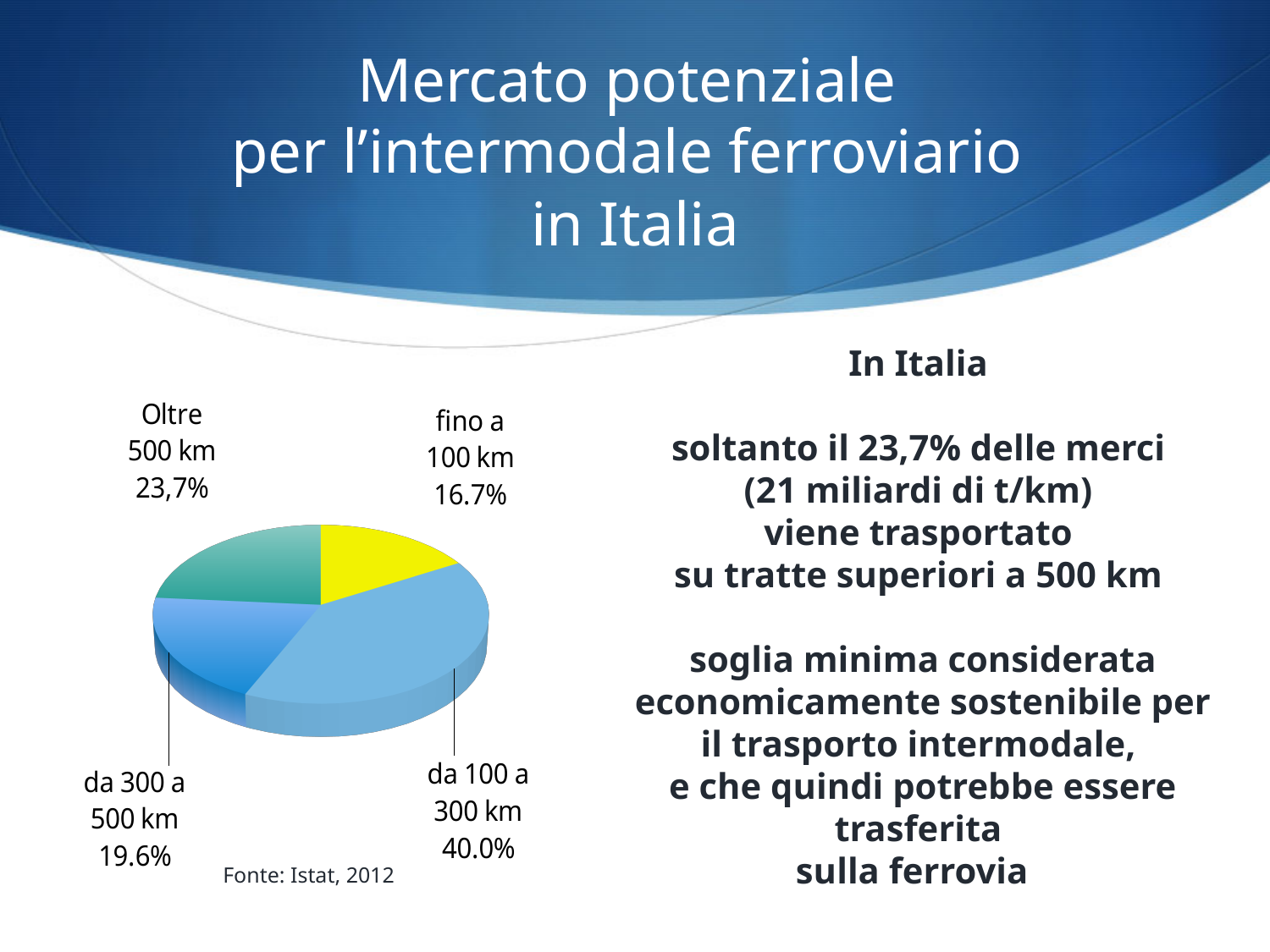
How many slices does the pie chart have? 4 What percentage is shown for the 'Oltre 500 km' slice? 23,7% What is the combined share of the 'da 300 a 500 km' and 'Oltre 500 km' slices? 43.3% Which distance band has the smallest share of the pie? fino a 100 km What percentage is shown for the 'da 300 a 500 km' slice? 19.6% What share of the pie does the 'da 100 a 300 km' slice represent? 40.0% What kind of chart is shown on the slide? Pie chart What percentage is shown for the 'fino a 100 km' slice? 16.7% What source is cited below the pie chart? Fonte: Istat, 2012 Which is larger: the share for 'Oltre 500 km' or the share for 'da 300 a 500 km'? Oltre 500 km Which distance band has the largest share of the pie? da 100 a 300 km What is the difference in percentage points between the 'da 100 a 300 km' slice and the 'fino a 100 km' slice? 23.3